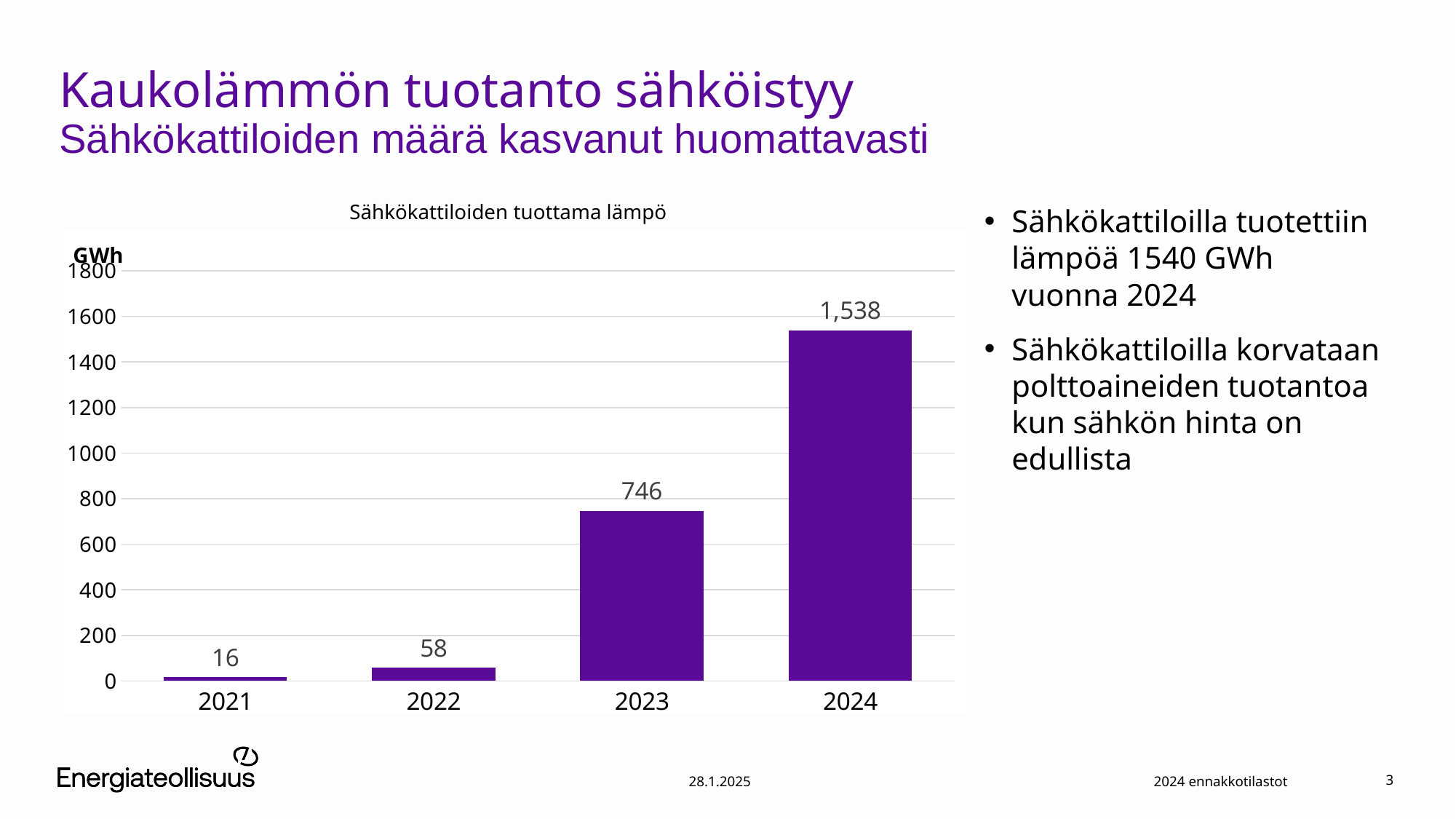
What is the value for 2022? 58 Is the value for 2023 greater or less than 800? less What is the value for 2024? 1,538 Which is larger, the value for 2022 or the value for 2023? 2023 What kind of chart is this? bar chart What is the difference between the values for 2024 and 2023? 792 How many years are shown on the x axis? 4 What is the value for 2023? 746 Which year has the lowest value? 2021 What is the value for 2021? 16 Do the values rise or fall from 2021 to 2024? rise Which year has the highest value? 2024